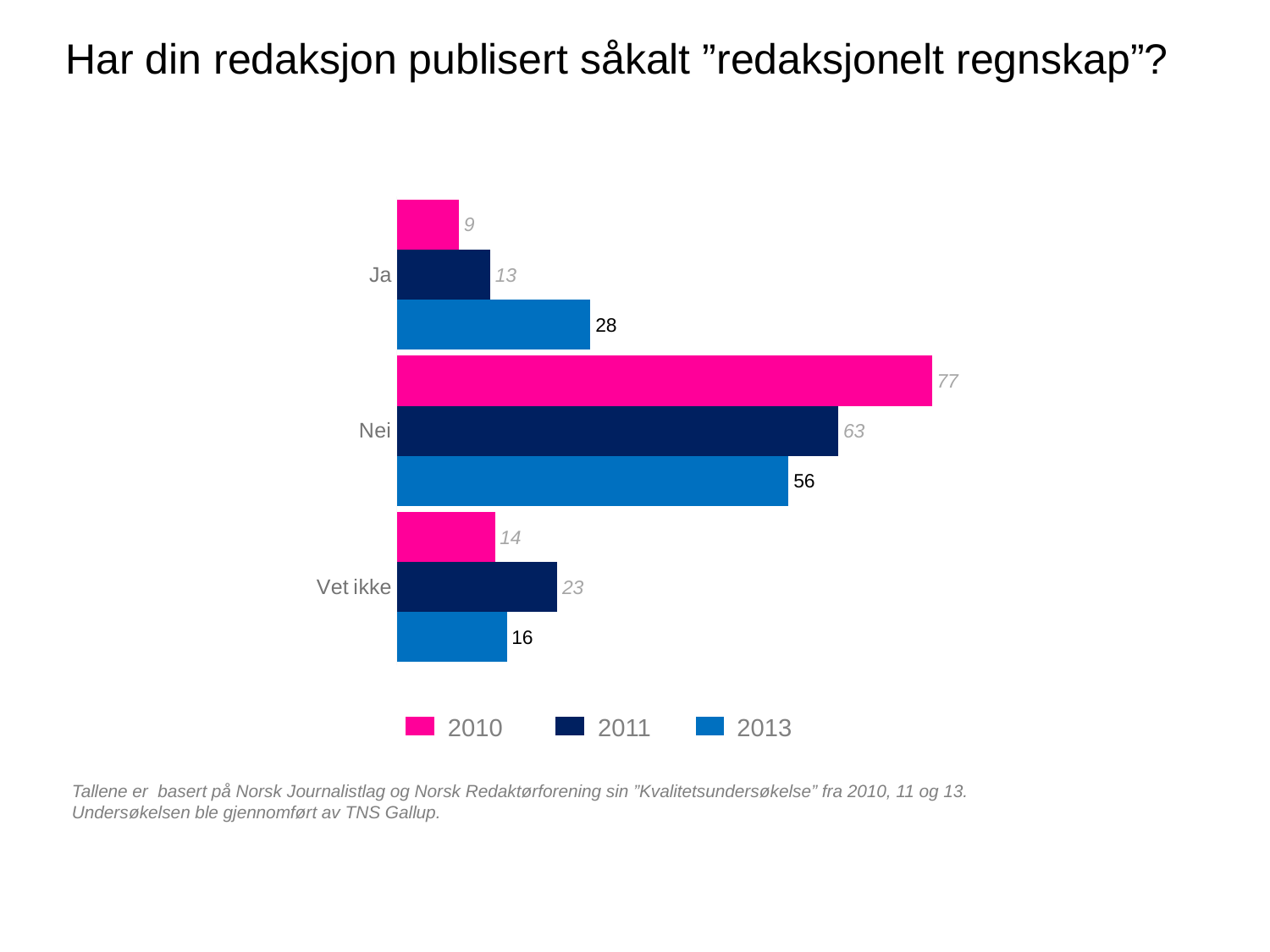
Which category has the highest value in the 2013 series? Nei What is the difference between the 2010 and 2013 values for "Nei"? 21 What is the value for "Vet ikke" in the 2011 series? 23 Which is larger for "Vet ikke": the 2011 value or the 2013 value? 2011 What kind of chart is shown on the slide? Bar chart How many categories are shown on the chart? 3 What is the value for "Ja" in the 2010 series? 9 What is the difference between the 2013 and 2011 values for "Ja"? 15 Which category has the lowest value in the 2010 series? Ja What is the value for "Ja" in the 2013 series? 28 How many series does the legend list? 3 What is the value for "Nei" in the 2010 series? 77